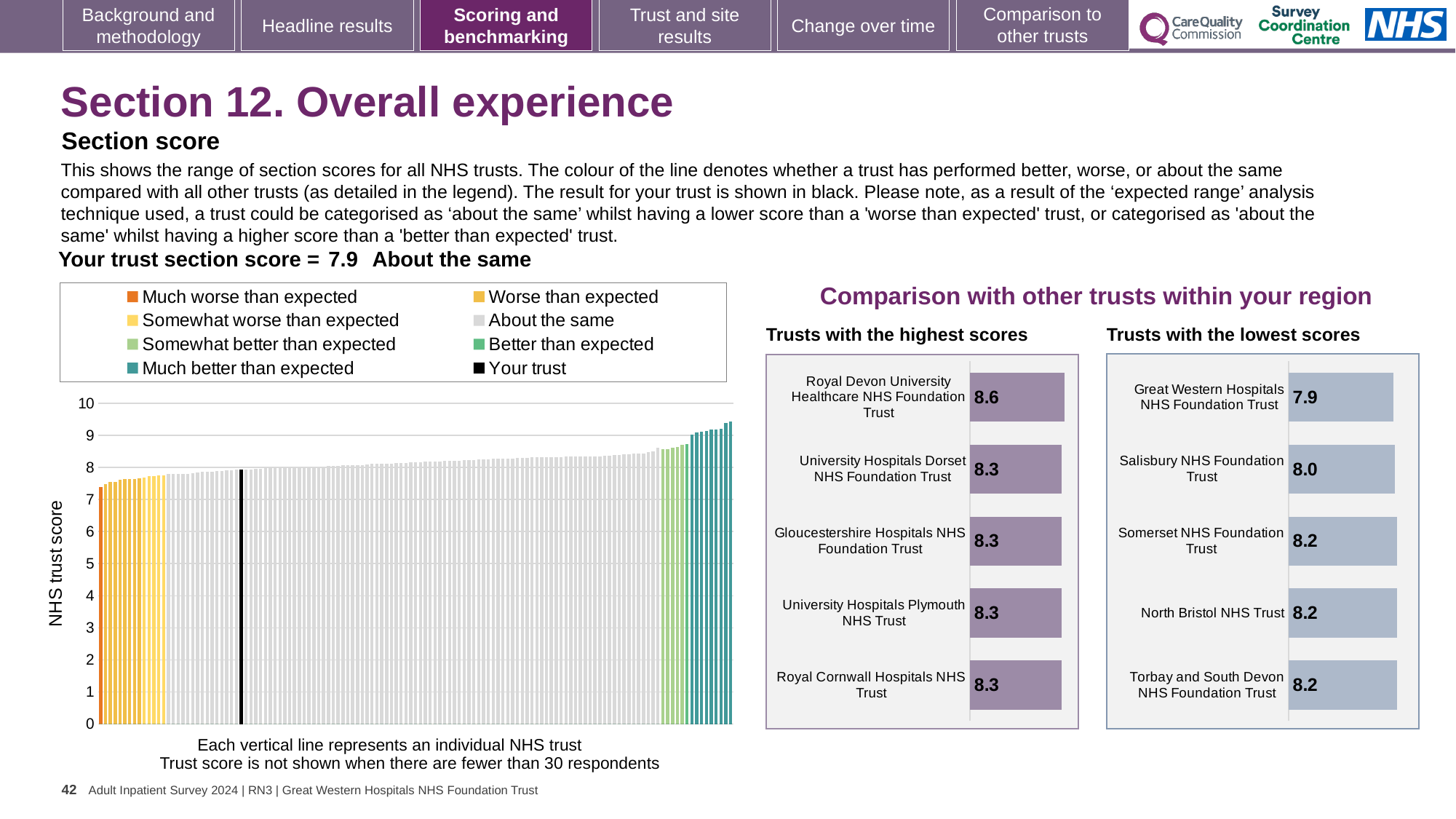
What is the label on the vertical axis of the large chart on the left? NHS trust score In the 'Trusts with the lowest scores' chart, what is the score for Salisbury NHS Foundation Trust? 8.0 In the large chart on the left, how many entries does the legend list? 8 In the 'Trusts with the lowest scores' chart, what is the score for Somerset NHS Foundation Trust? 8.2 What kind of chart is the large chart on the left showing NHS trust scores? Bar chart In the large chart on the left, is the value of the tallest bar greater or less than 9? greater In the 'Trusts with the highest scores' chart, which trust has the highest score? Royal Devon University Healthcare NHS Foundation Trust In the 'Trusts with the highest scores' chart, what is the difference between the scores of Royal Devon University Healthcare NHS Foundation Trust and University Hospitals Dorset NHS Foundation Trust? 0.3 In the 'Trusts with the lowest scores' chart, which has the larger score: Salisbury NHS Foundation Trust or Great Western Hospitals NHS Foundation Trust? Salisbury NHS Foundation Trust In the 'Trusts with the lowest scores' chart, which trust has the lowest score? Great Western Hospitals NHS Foundation Trust In the 'Trusts with the highest scores' chart, what is the score for Royal Devon University Healthcare NHS Foundation Trust? 8.6 In the 'Trusts with the highest scores' chart, how many trusts are shown? 5